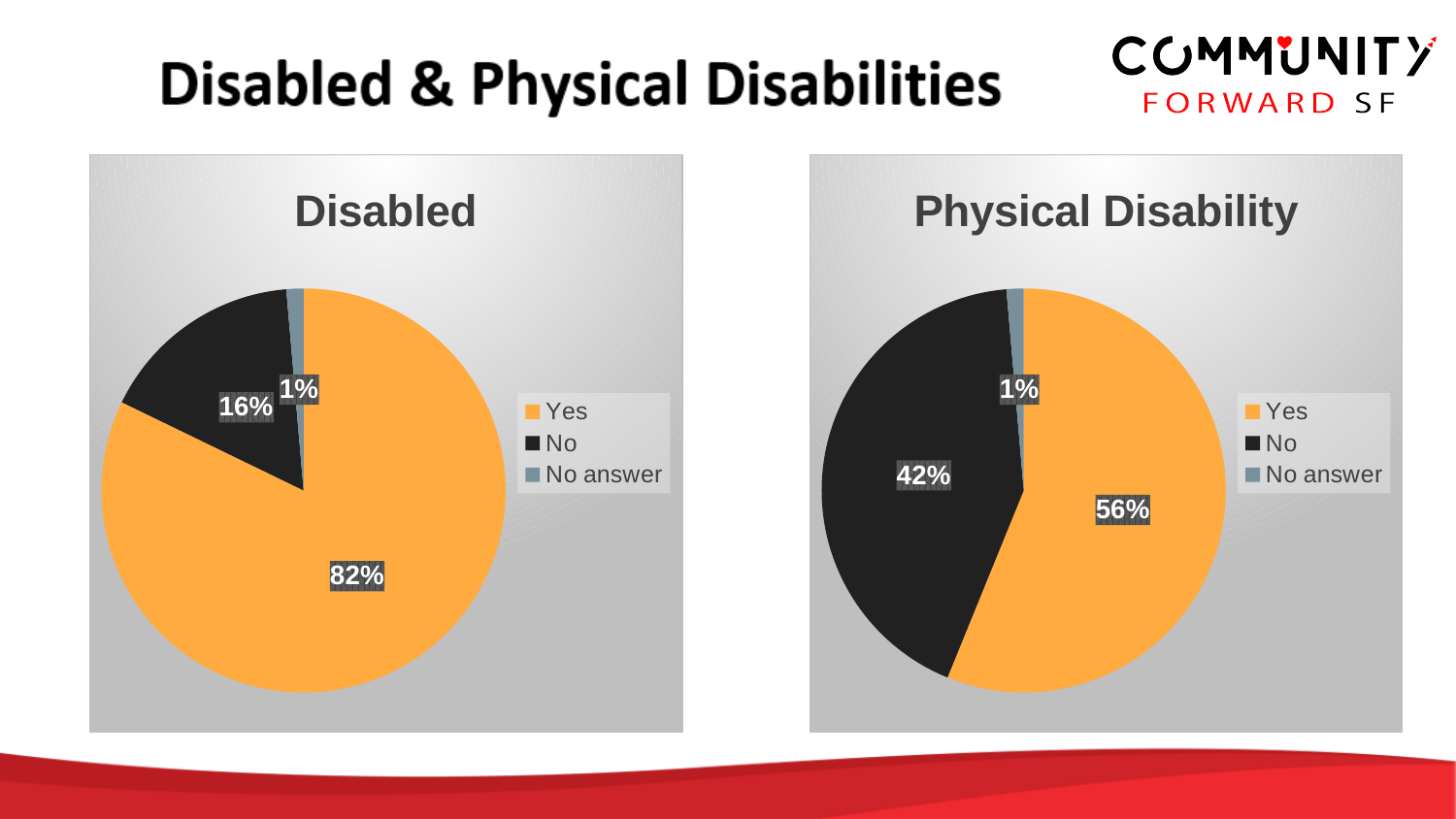
In the "Disabled" chart, what percentage is shown for Yes? 82% In the "Physical Disability" chart, what percentage is shown for Yes? 56% What type of chart is the "Disabled" chart? Pie chart In the "Physical Disability" chart, which is larger, Yes or No? Yes In the "Physical Disability" chart, which category has the smallest slice? No answer In the "Disabled" chart, what is the difference in percentage points between Yes and No? 66 In the "Physical Disability" chart, what percentage is shown for No? 42% In the "Disabled" chart, what percentage is shown for No? 16% In the "Disabled" chart, which category has the largest slice? Yes In the "Physical Disability" chart, what percentage is shown for No answer? 1% How many categories does the legend of the "Physical Disability" chart list? 3 In the "Disabled" chart, what colour is the Yes slice? Orange